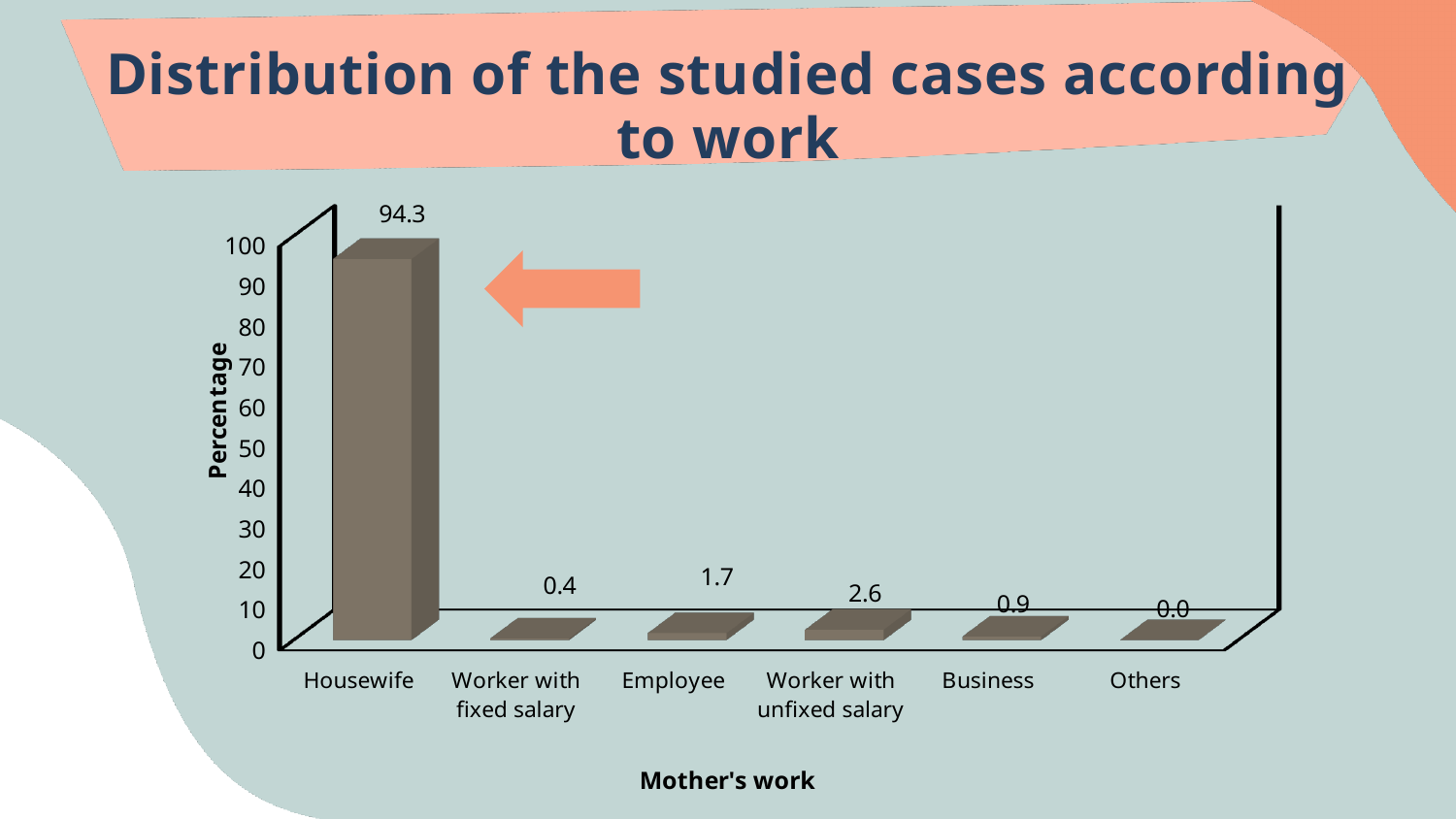
What kind of chart is shown on the slide? Bar chart Is the value for Housewife greater or less than 90? greater Which category of mother's work has the highest percentage? Housewife What is the difference between the percentages for Housewife and Worker with unfixed salary? 91.7 What is the percentage for Housewife? 94.3 Which is larger, the percentage for Employee or for Business? Employee What is the percentage for Employee? 1.7 What is the percentage for Worker with unfixed salary? 2.6 What is the label of the y axis? Percentage How many categories of mother's work are shown on the x axis? 6 Which category of mother's work has the lowest percentage? Others What is the percentage for Business? 0.9